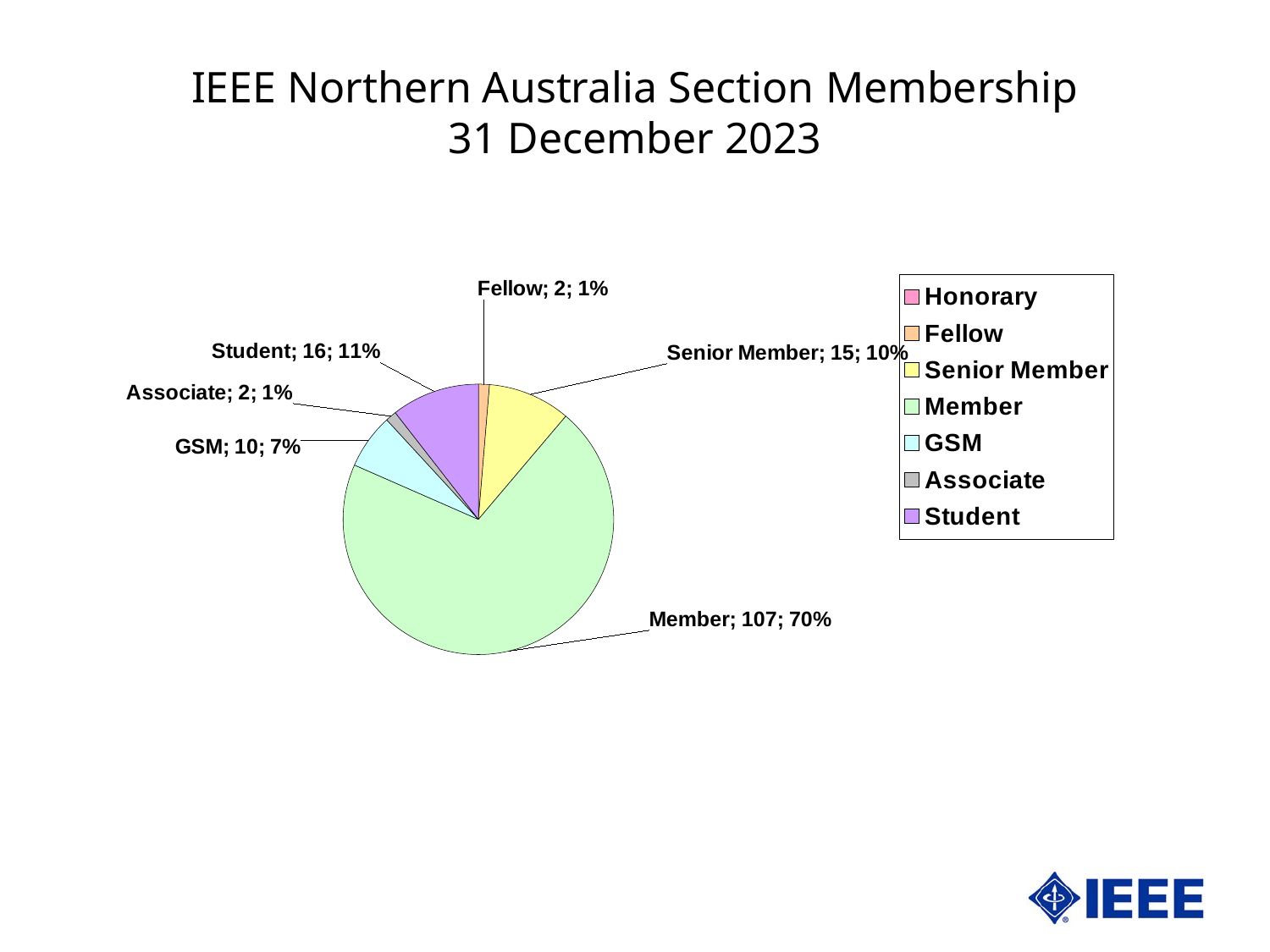
What kind of chart is shown on the slide? pie chart What colour is the Member slice in the pie chart? light green What is the difference between the Student count and the Senior Member count? 1 How many GSM members are shown? 10 Which is larger, the GSM count or the Senior Member count? Senior Member What is the difference between the Member count and the GSM count? 97 Which category has the largest slice of the pie? Member How many Senior Members are shown? 15 What share of the pie does the Member slice represent? 70% How many members are in the Member category? 107 What percentage of membership is Student? 11% How many entries does the legend list? 7